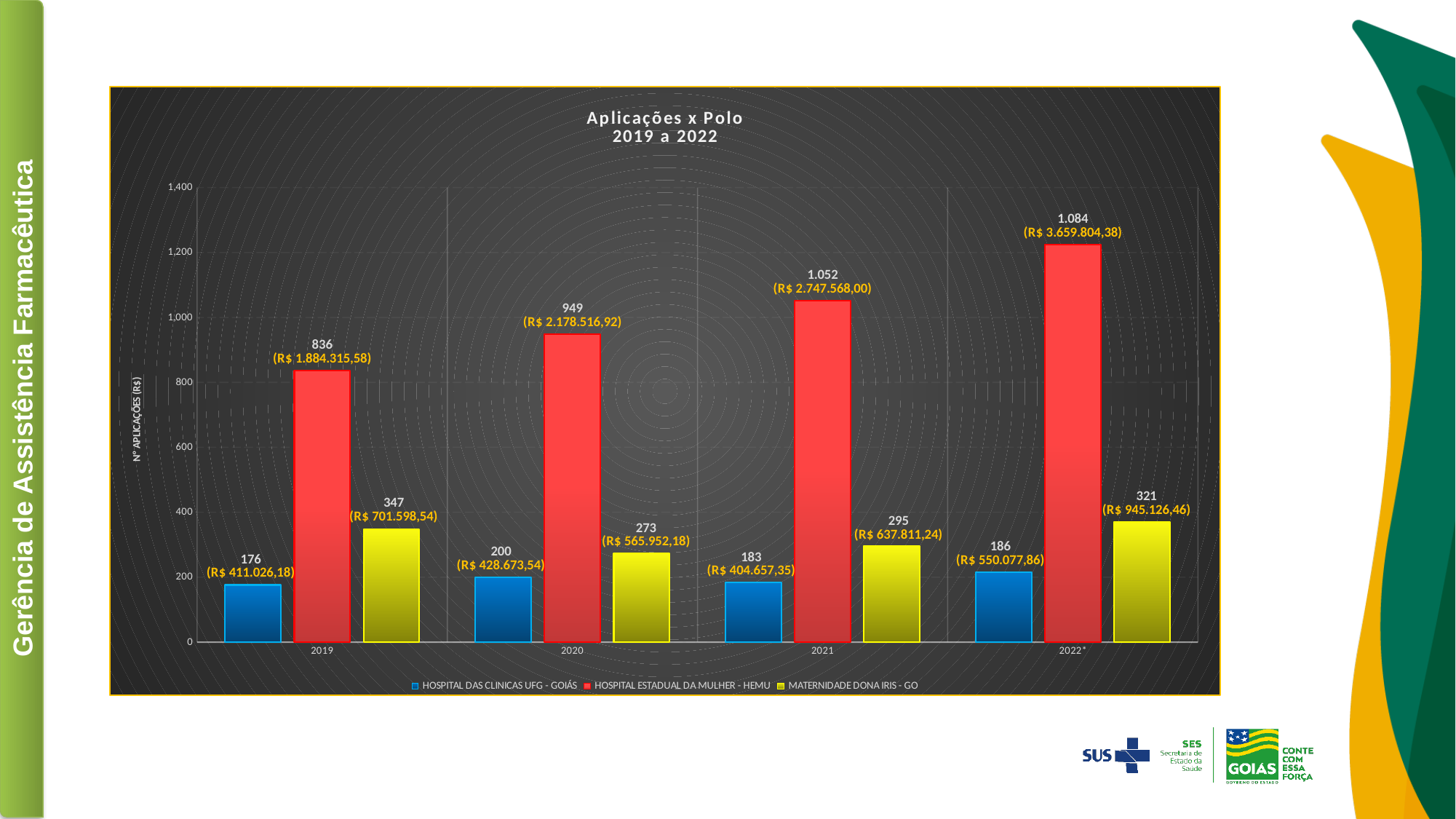
How many series does the legend list? 3 How many year categories are shown on the x axis? 4 What is the R$ value shown for MATERNIDADE DONA IRIS - GO in 2022*? R$ 945.126,46 Which series has more applications in 2019: HOSPITAL DAS CLINICAS UFG - GOIÁS or MATERNIDADE DONA IRIS - GO? MATERNIDADE DONA IRIS - GO What is the difference in applications between HOSPITAL ESTADUAL DA MULHER - HEMU and MATERNIDADE DONA IRIS - GO in 2021? 757 What is the number of applications for HOSPITAL DAS CLINICAS UFG - GOIÁS in 2020? 200 In which year does HOSPITAL ESTADUAL DA MULHER - HEMU have the highest number of applications? 2022* What is the number of applications for HOSPITAL ESTADUAL DA MULHER - HEMU in 2019? 836 What type of chart is shown on the slide? Bar chart In which year does MATERNIDADE DONA IRIS - GO have the lowest number of applications? 2020 What is the title of the chart? Aplicações x Polo 2019 a 2022 Do the applications for HOSPITAL ESTADUAL DA MULHER - HEMU rise or fall from 2019 to 2022*? Rise